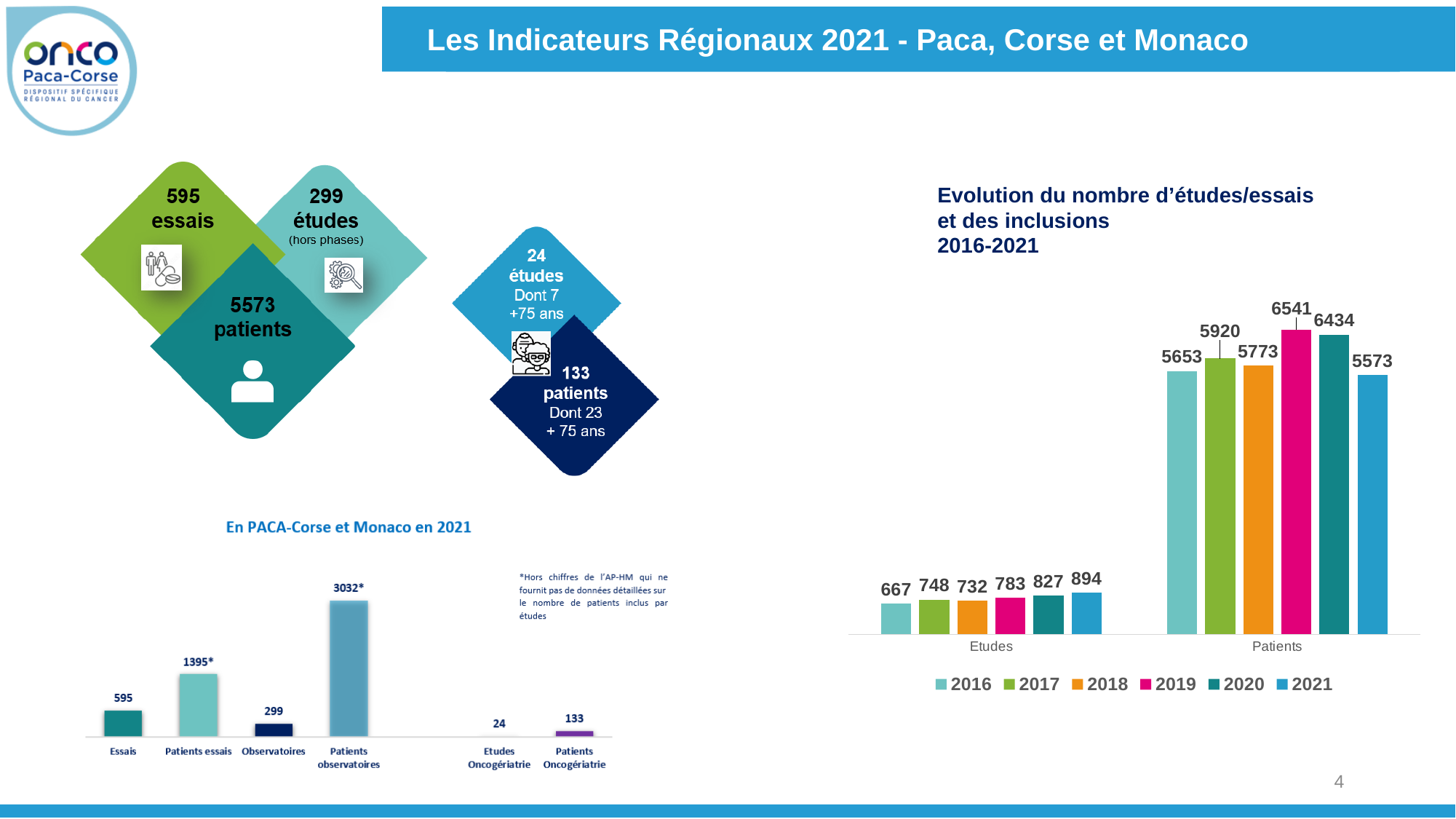
In the chart 'En PACA-Corse et Monaco en 2021', what is the value for Patients observatoires? 3032* In the chart 'Evolution du nombre d'études/essais et des inclusions 2016-2021', what is the value for Etudes in 2016? 667 In the chart 'Evolution du nombre d'études/essais et des inclusions 2016-2021', what is the difference between the Patients values for 2020 and 2021? 861 In the chart 'En PACA-Corse et Monaco en 2021', how many categories are shown? 6 In the chart 'En PACA-Corse et Monaco en 2021', which is larger, Essais or Observatoires? Essais What kind of chart is 'En PACA-Corse et Monaco en 2021'? bar chart In the chart 'En PACA-Corse et Monaco en 2021', which category has the lowest value? Etudes Oncogériatrie In the chart 'Evolution du nombre d'études/essais et des inclusions 2016-2021', what is the value for Patients in 2019? 6541 In the chart 'Evolution du nombre d'études/essais et des inclusions 2016-2021', how many series does the legend list? 6 In the chart 'Evolution du nombre d'études/essais et des inclusions 2016-2021', do the Etudes values rise or fall from 2019 to 2021? rise In the chart 'Evolution du nombre d'études/essais et des inclusions 2016-2021', which year has the highest value for Patients? 2019 In the chart 'Evolution du nombre d'études/essais et des inclusions 2016-2021', which year has the lowest value for Etudes? 2016